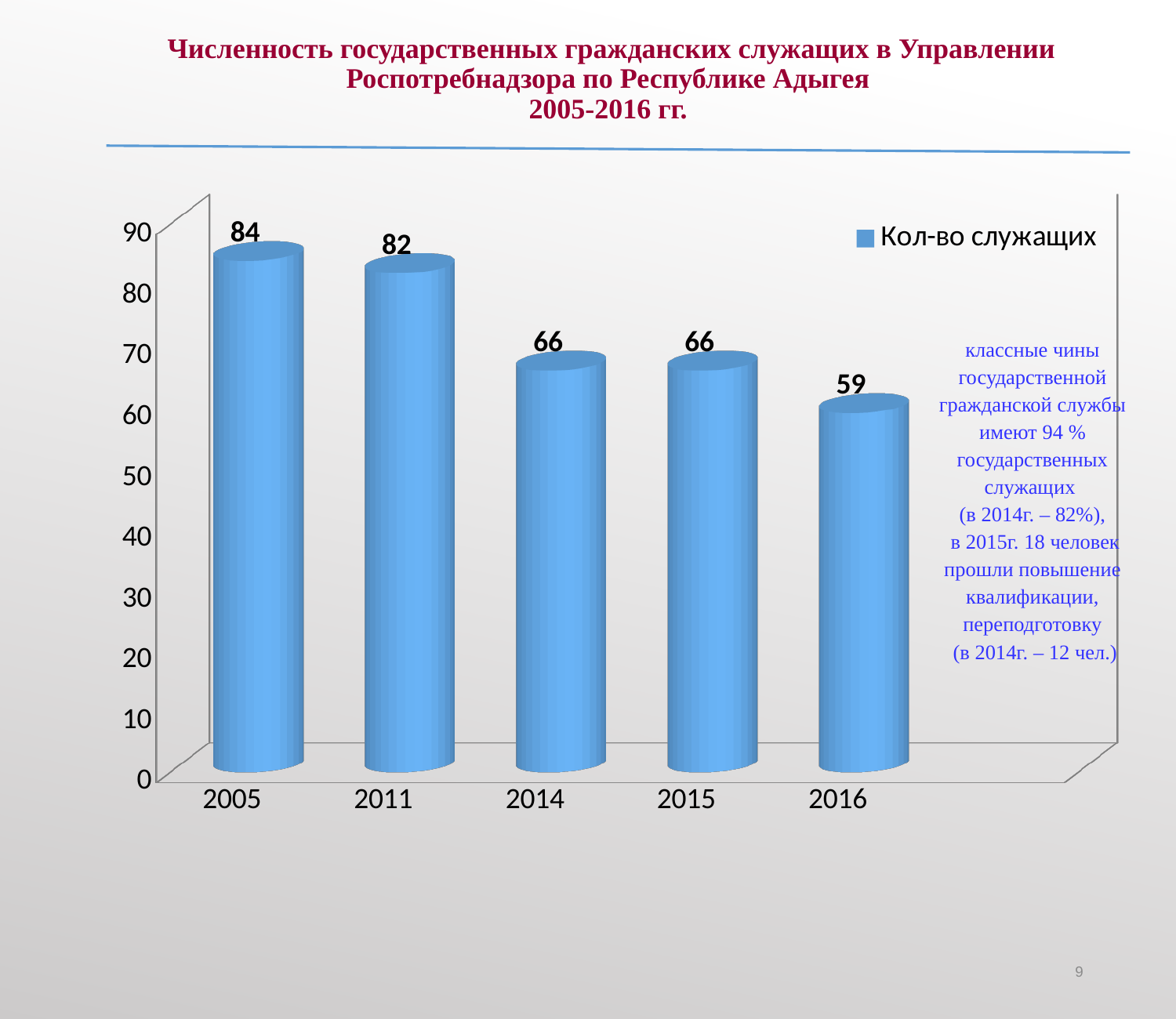
What is the value for 2016? 59 What is the difference between the values for 2005 and 2016? 25 What is the value for 2005? 84 Is the value for 2015 greater or less than 70? less Which is larger, the value for 2011 or the value for 2014? 2011 Do the values rise or fall from 2005 to 2016? fall Which year has the lowest value? 2016 How many series does the legend list? 1 How many years are shown on the x axis? 5 What kind of chart is shown? bar chart Which year has the highest value? 2005 What is the value for 2011? 82